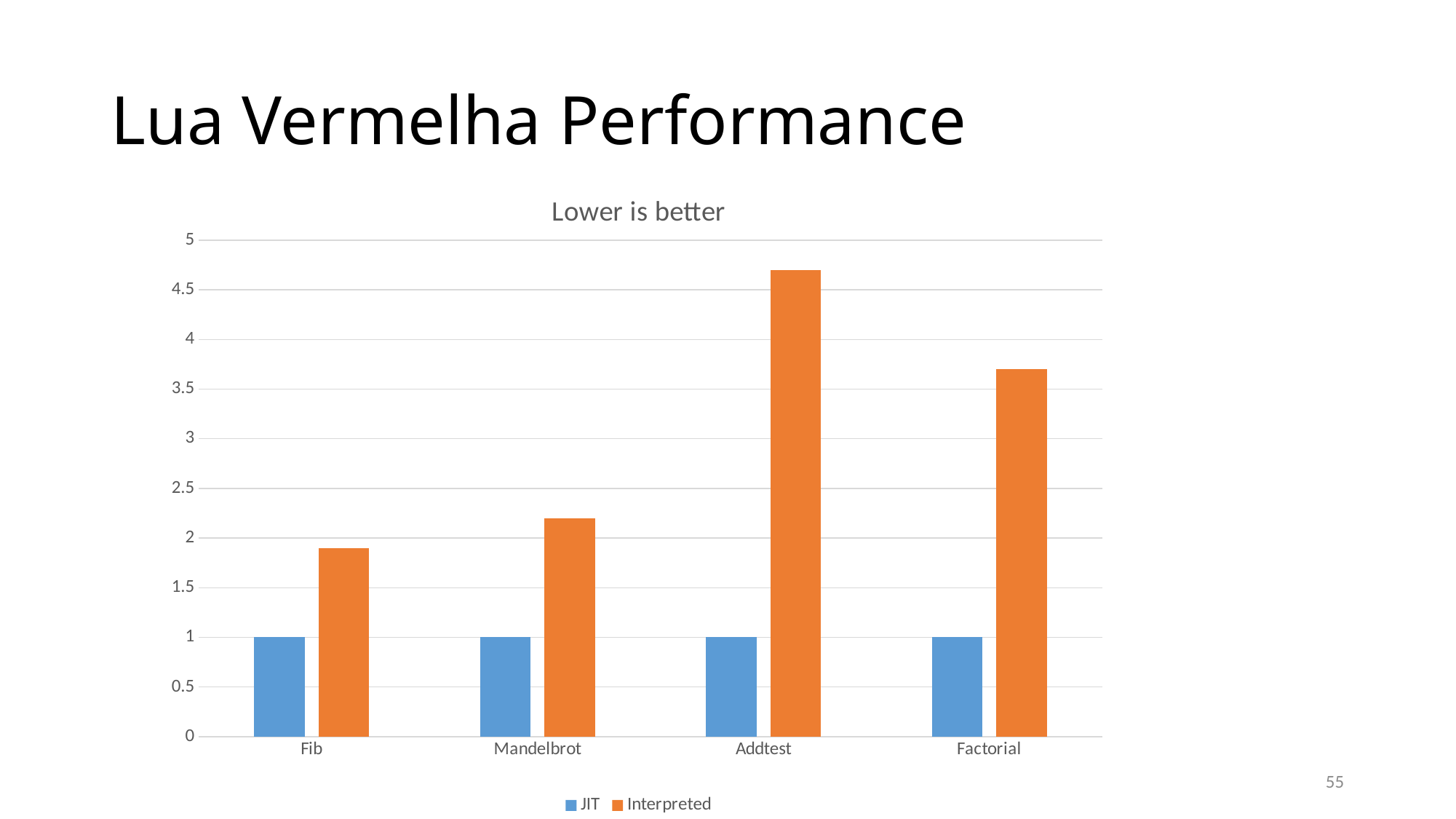
Is the Interpreted value for Fib greater or less than 2? less Which category has the highest Interpreted value? Addtest What kind of chart is shown on the slide? bar chart What is the JIT value for Factorial? 1 What is the JIT value for Fib? 1 Is the Interpreted value for Addtest greater or less than 4.5? greater Which is larger, the Interpreted value for Mandelbrot or the Interpreted value for Factorial? Factorial How many categories are shown on the x axis? 4 How many series does the legend list? 2 What is the title of the chart? Lower is better Which series is shown in orange? Interpreted Which category has the lowest Interpreted value? Fib